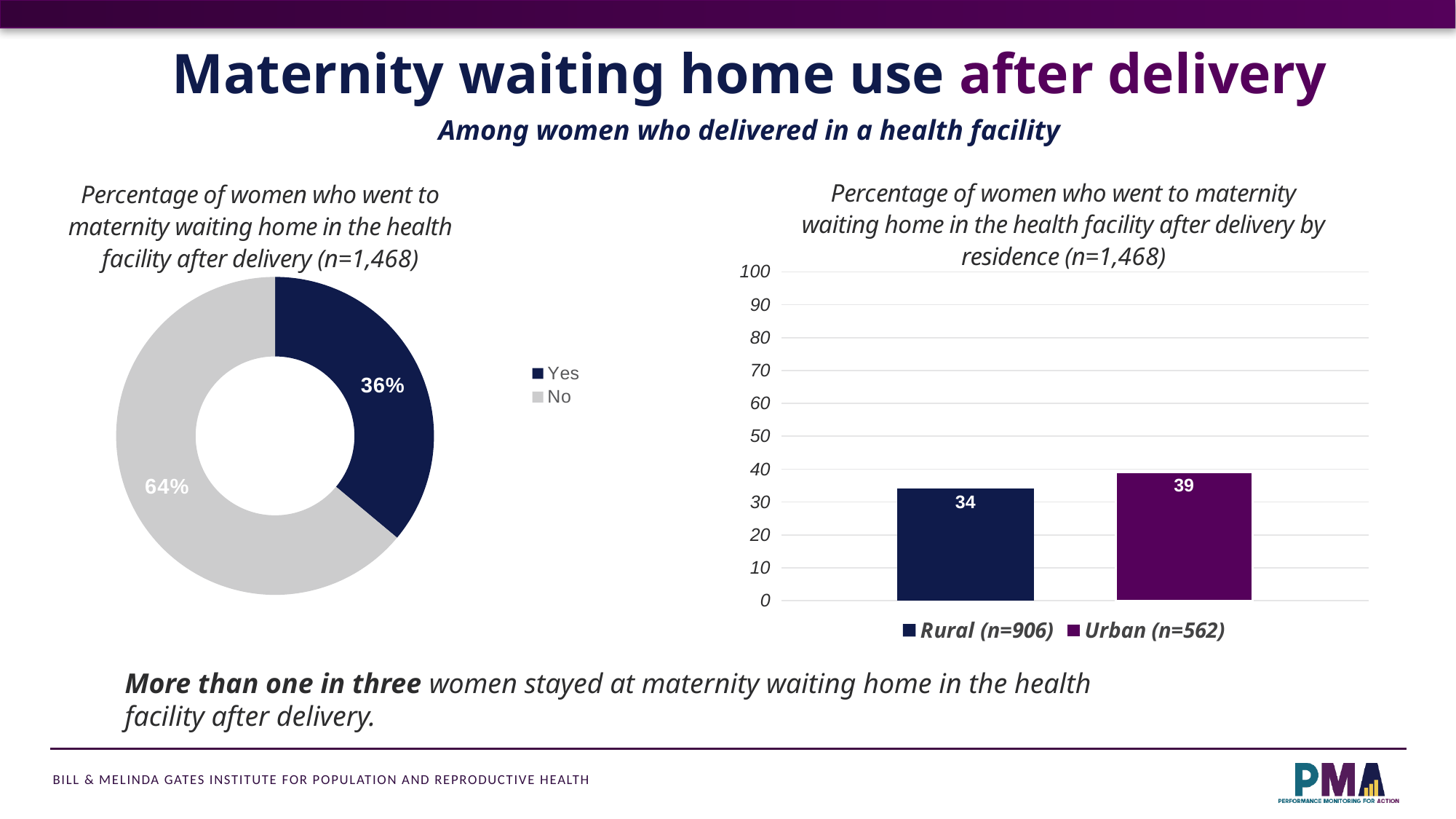
In the right chart (by residence), what is the difference between the Urban and Rural values? 5 In the left chart (donut), how many categories does the legend list? 2 In the left chart (donut), what is the difference in percentage points between No and Yes? 28 In the left chart (donut), which category has the larger share, Yes or No? No In the right chart (by residence), which group has the higher value? Urban (n=562) In the left chart (donut), what percentage of women answered No? 64% In the left chart (donut), what percentage of women answered Yes? 36% What kind of chart is the right chart on the slide? Bar chart What kind of chart is the left chart on the slide? Donut (pie) chart In the right chart (by residence), what is the value for Urban (n=562)? 39 In the right chart (by residence), what is the value for Rural (n=906)? 34 In the right chart (by residence), is the value for Rural greater or less than 40? less